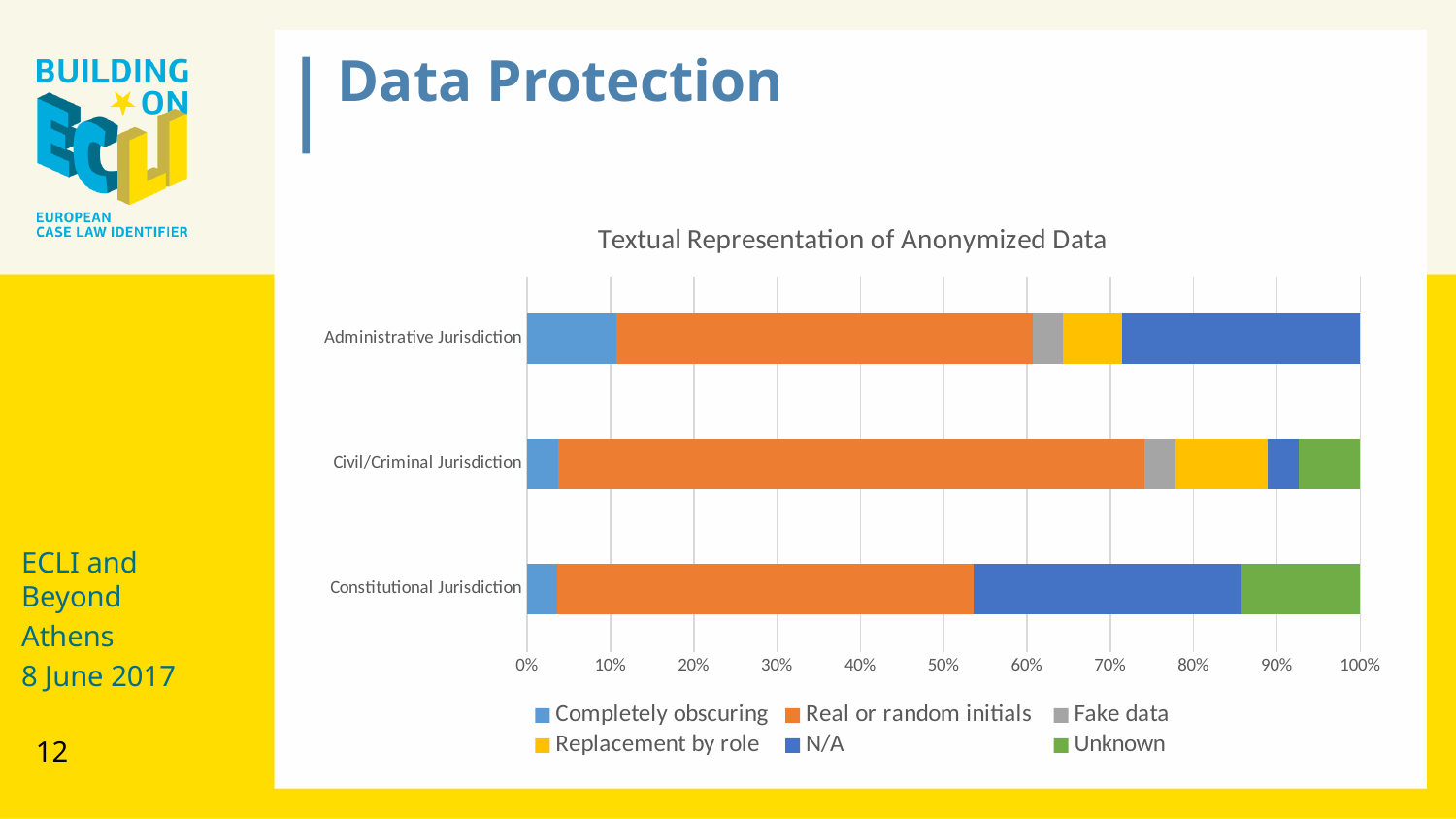
How many series does the chart legend list? 6 Which jurisdiction has the smallest 'N/A' segment? Civil/Criminal Jurisdiction Is the 'Completely obscuring' value for Constitutional Jurisdiction greater or less than 10%? less Which series is shown in green in the chart? Unknown Is the 'Unknown' value for Civil/Criminal Jurisdiction greater or less than 10%? less Which jurisdiction has the largest 'Real or random initials' segment? Civil/Criminal Jurisdiction Is the 'Real or random initials' value for Civil/Criminal Jurisdiction greater or less than 60%? greater Which jurisdiction has the largest 'Completely obscuring' segment? Administrative Jurisdiction How many jurisdiction categories are plotted in the chart? 3 Is the 'Unknown' segment larger for Constitutional Jurisdiction or Civil/Criminal Jurisdiction? Constitutional Jurisdiction What is the title of the chart? Textual Representation of Anonymized Data What type of chart is shown on the slide? Stacked bar chart